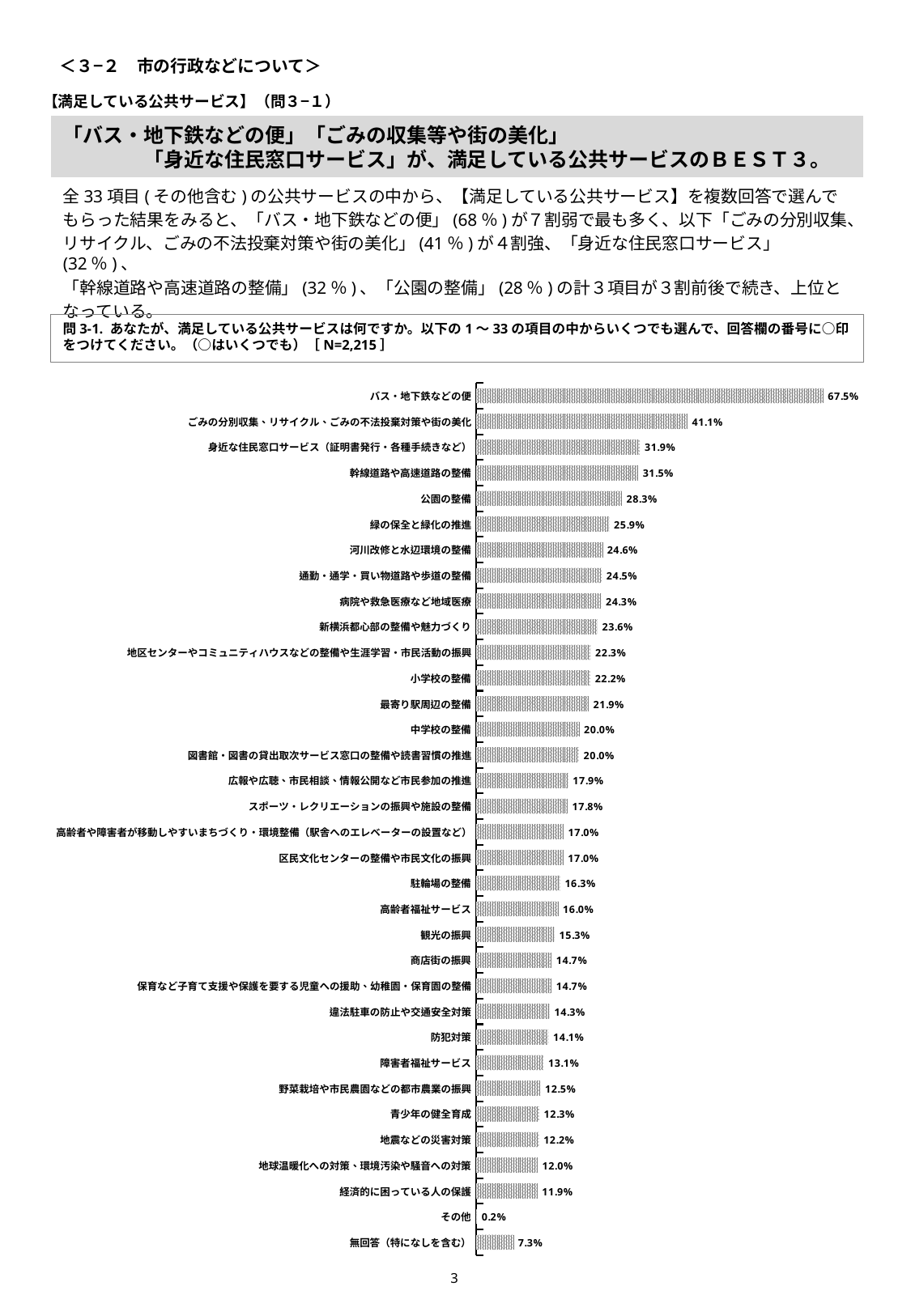
Which category has the highest value? バス・地下鉄などの便 What is the difference between the values for バス・地下鉄などの便 and ごみの分別収集、リサイクル、ごみの不法投棄対策や街の美化? 26.4% What is the value for 無回答（特になしを含む）? 7.3% Which is larger, the value for 駐輪場の整備 or the value for 観光の振興? 駐輪場の整備 What is the value for 公園の整備? 28.3% What is the sample size (N) stated in the question heading above the chart? N=2,215 What is the difference between the values for 幹線道路や高速道路の整備 and 公園の整備? 3.2% What is the value for バス・地下鉄などの便? 67.5% What is the value for 経済的に困っている人の保護? 11.9% What kind of chart is shown on the slide? Bar chart Which category has the lowest value? その他 How many bars are plotted in the chart? 34